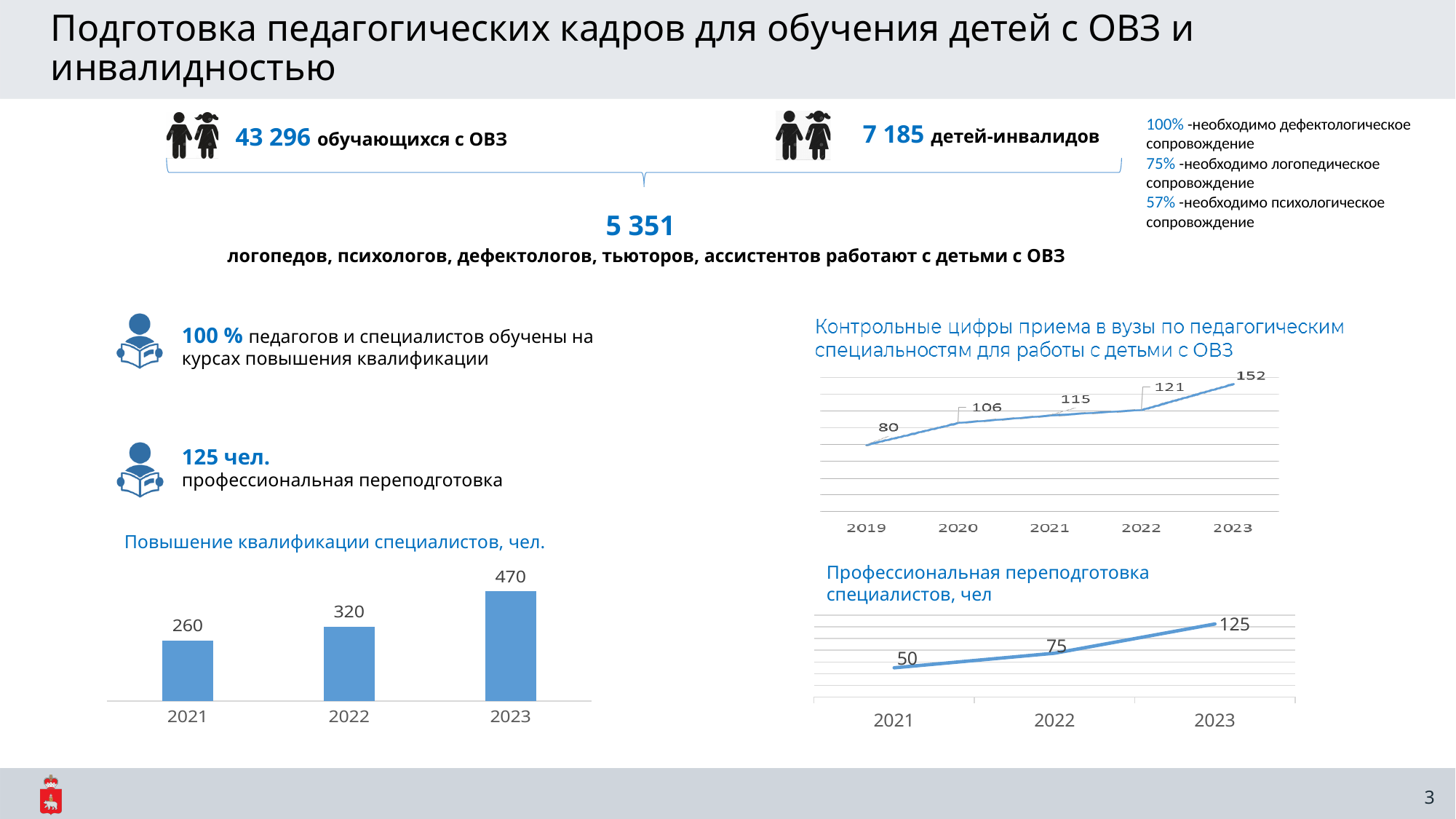
Как изменяются значения на диаграмме «Контрольные цифры приема в вузы по педагогическим специальностям для работы с детьми с ОВЗ» с 2019 по 2023 год — растут или падают? Растут Сколько категорий (лет) показано на диаграмме «Повышение квалификации специалистов, чел.»? 3 На диаграмме «Профессиональная переподготовка специалистов, чел» какое значение больше — за 2021 или за 2023 год? 2023 На диаграмме «Повышение квалификации специалистов, чел.» какое значение указано для 2023 года? 470 На диаграмме «Контрольные цифры приема в вузы по педагогическим специальностям для работы с детьми с ОВЗ» на сколько значение 2023 года больше значения 2019 года? 72 Сколько точек данных показано на диаграмме «Контрольные цифры приема в вузы по педагогическим специальностям для работы с детьми с ОВЗ»? 5 На диаграмме «Повышение квалификации специалистов, чел.» на сколько значение 2023 года больше значения 2022 года? 150 На диаграмме «Контрольные цифры приема в вузы по педагогическим специальностям для работы с детьми с ОВЗ» какой год имеет наибольшее значение? 2023 На диаграмме «Контрольные цифры приема в вузы по педагогическим специальностям для работы с детьми с ОВЗ» какое значение указано для 2020 года? 106 На диаграмме «Профессиональная переподготовка специалистов, чел» какое значение указано для 2022 года? 75 Какого типа диаграмма «Повышение квалификации специалистов, чел.»? Столбчатая (bar chart) На диаграмме «Повышение квалификации специалистов, чел.» какой год имеет наименьшее значение? 2021